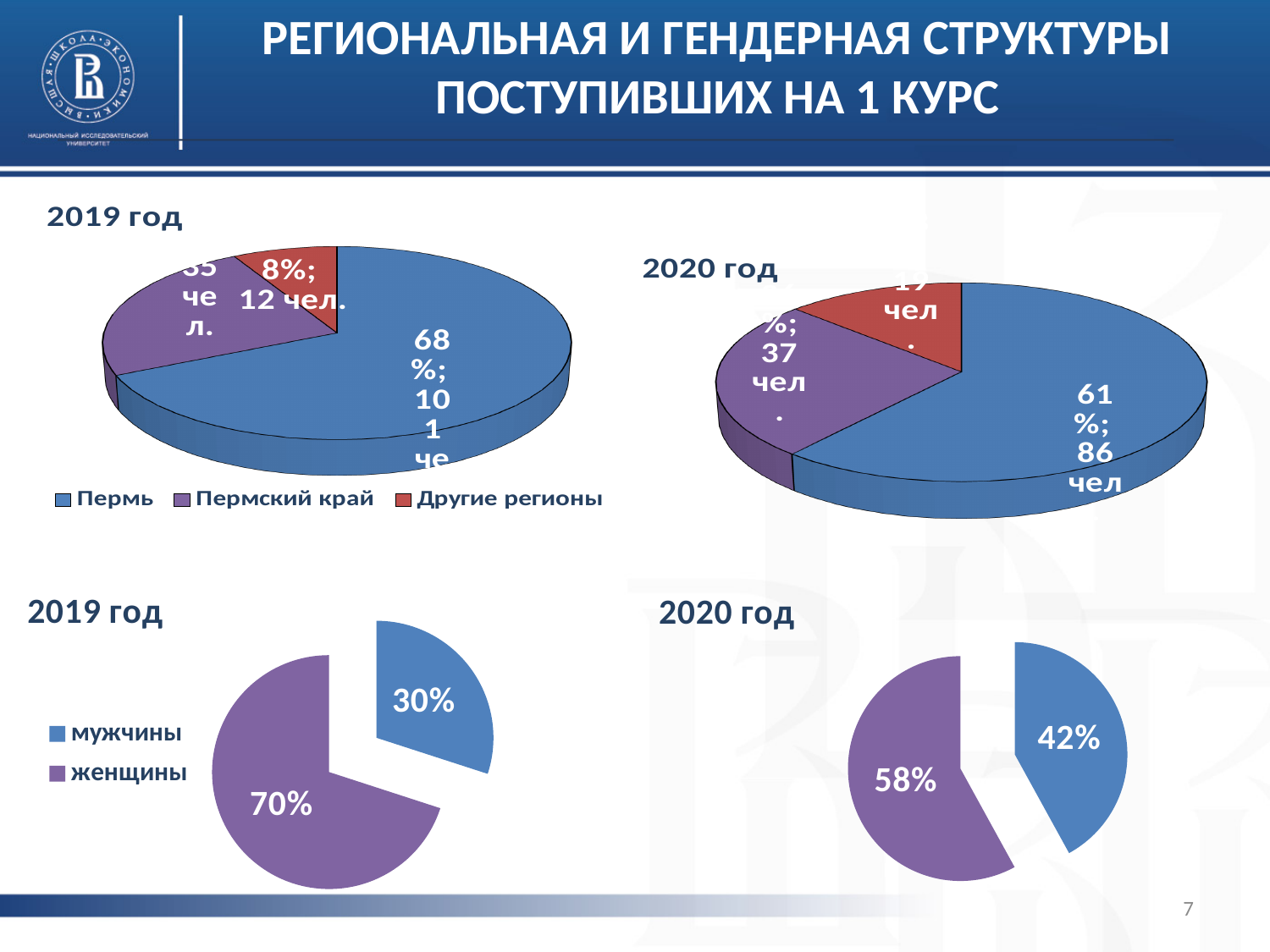
In the top-left pie chart (2019 год, regional structure), what percentage is shown for Пермь? 68% In the bottom-right pie chart (2020 год, gender structure), what share is labelled for женщины? 58% How many categories does the legend of the top regional-structure charts list? 3 In the bottom-left pie chart (2019 год, gender structure), what is the difference in percentage points between женщины and мужчины? 40 percentage points What kind of chart is used for the gender structure in the bottom-left (2019 год)? Pie chart In the top-right pie chart (2020 год, regional structure), which region has the largest slice? Пермь In the bottom-left pie chart (2019 год, gender structure), what share is labelled for мужчины? 30% In the bottom-left pie chart (2019 год, gender structure), what share is labelled for женщины? 70% In the top-right pie chart (2020 год, regional structure), how many people are shown for Пермский край? 37 чел. In the top-right pie chart (2020 год, regional structure), what percentage is shown for Пермь? 61% In the top-left pie chart (2019 год, regional structure), how many people are shown for Другие регионы? 12 чел. In the bottom-right pie chart (2020 год, gender structure), what share is labelled for мужчины? 42%